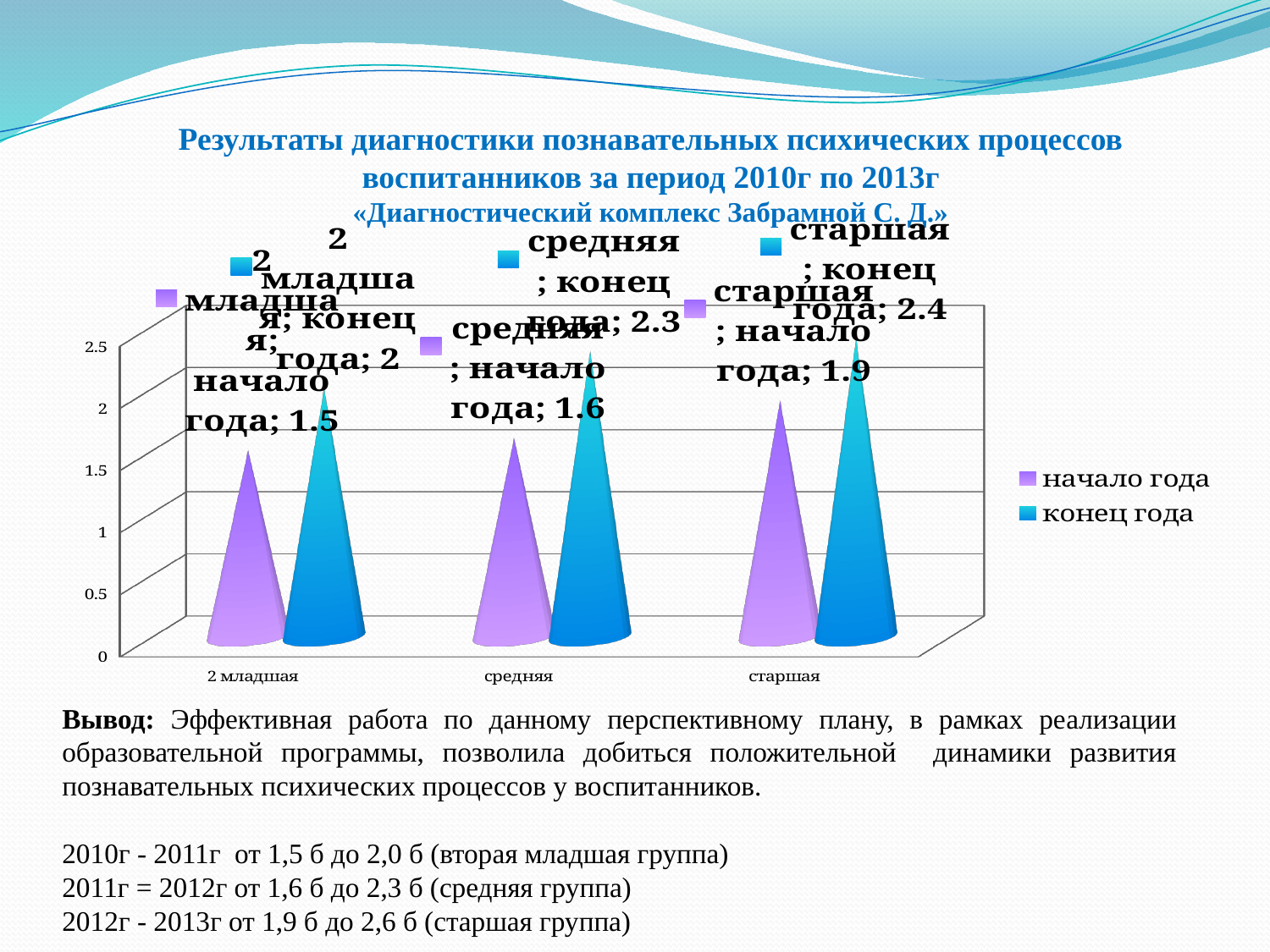
What is the value for "конец года" in the "средняя" category? 2.3 Which is larger: the "конец года" value for "2 младшая" or the "начало года" value for "старшая"? конец года for 2 младшая How many categories are shown on the x axis? 3 What is the value for "конец года" in the "старшая" category? 2.4 Do the "конец года" values rise or fall from "2 младшая" to "старшая"? rise How many series does the legend list? 2 What is the value for "начало года" in the "старшая" category? 1.9 What is the value for "начало года" in the "2 младшая" category? 1.5 Which category has the highest "конец года" value? старшая What is the difference between the "конец года" and "начало года" values for the "средняя" category? 0.7 What kind of chart is shown on the slide? bar chart Which category has the lowest "начало года" value? 2 младшая